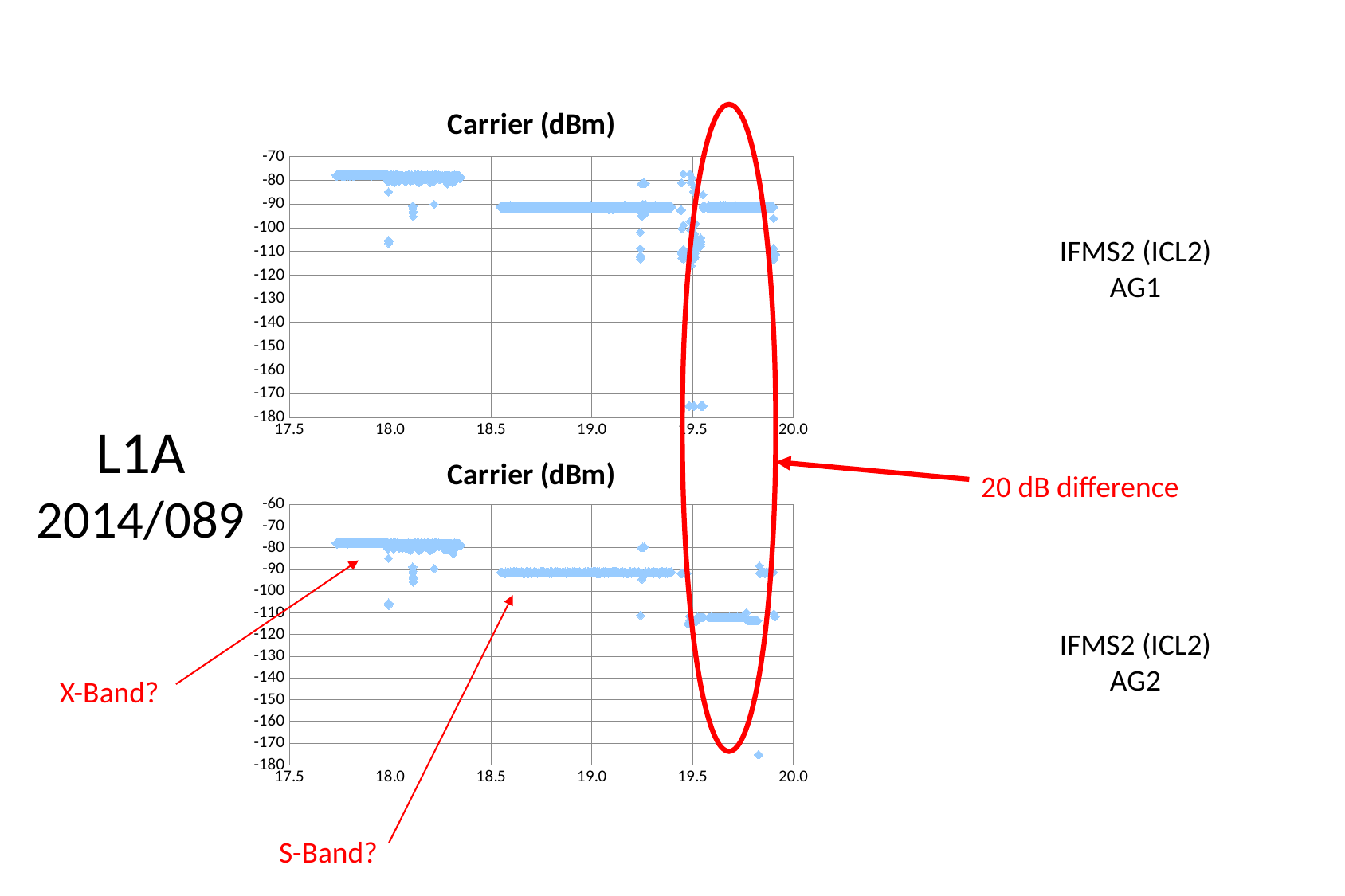
In the top chart, is the value at x = 17.8 greater or less than -90? greater In the top chart, do the plotted values rise or fall from x = 17.8 to x = 18.8? fall In the bottom chart, is the value at x = 19.7 greater or less than -100? less What kind of chart is the top chart on the slide? scatter chart In the bottom chart, do the plotted values generally rise or fall as x increases from 17.7 to 19.7? fall In the top chart, is the value at x = 18.8 greater or less than -80? less How many charts are shown on the slide? 2 In the bottom chart, which is higher: the value at x = 17.8 or the value at x = 19.7? x = 17.8 In the top chart, what is the highest value shown on the y axis? -70 What is the title of the top chart? Carrier (dBm) In the bottom chart, what is the highest value shown on the y axis? -60